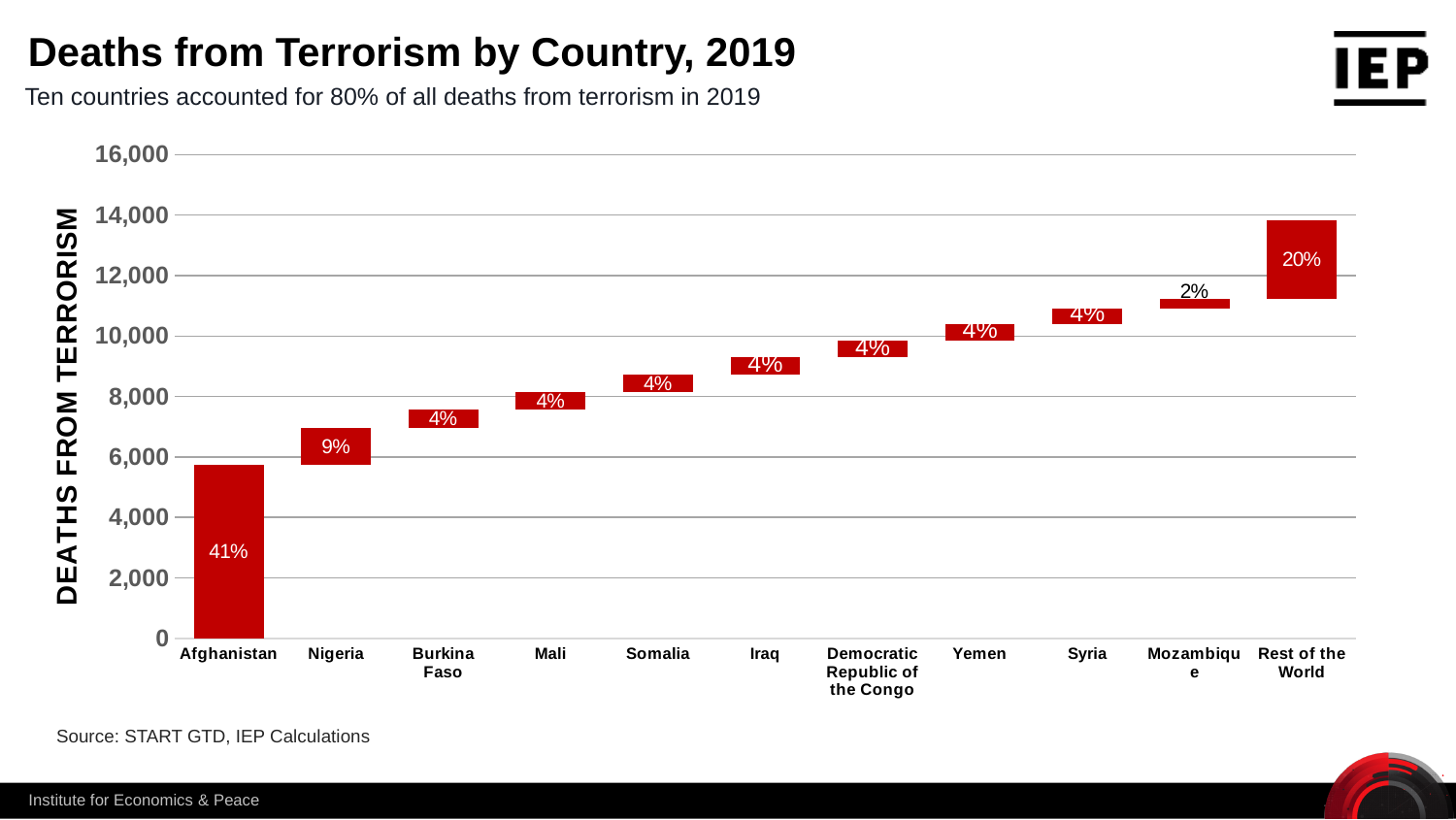
What kind of chart is shown on the slide? Bar chart What percentage label is shown for Rest of the World? 20% What percentage label is shown for Mozambique? 2% How many categories are shown along the x axis? 11 Which has a larger percentage label, Nigeria or Mozambique? Nigeria What is the difference between the percentage labels for Afghanistan and Nigeria? 32% Which country has the lowest percentage label on the chart? Mozambique Is the top of the Afghanistan bar greater or less than 6,000 deaths? less What percentage label is shown for Afghanistan? 41% What percentage label is shown for Nigeria? 9% Which country has the highest share of deaths from terrorism? Afghanistan What is the title of the chart? Deaths from Terrorism by Country, 2019